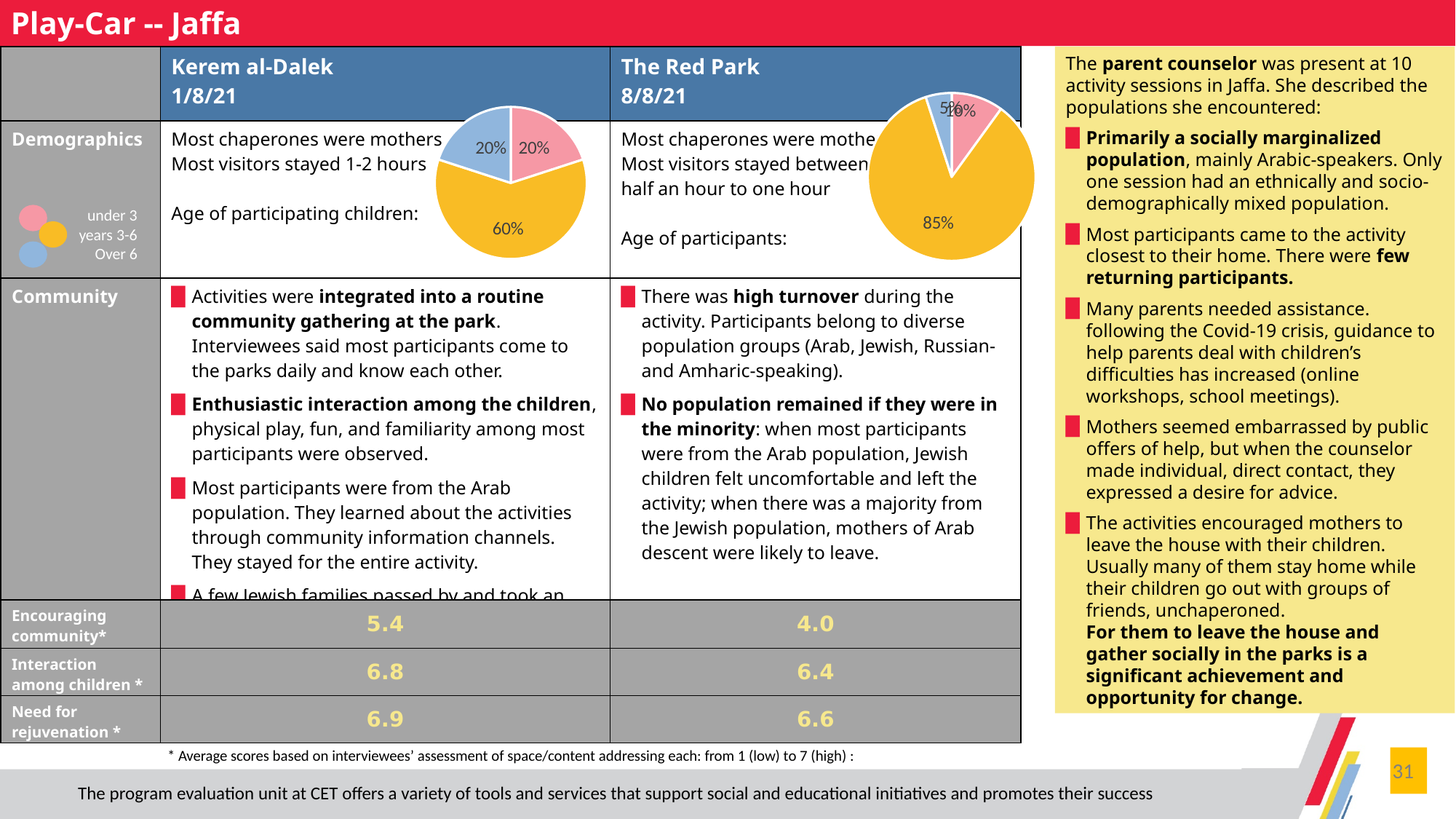
In the Kerem al-Dalek pie chart, what share of participating children were over 6? 20% In the Kerem al-Dalek pie chart, which age group has the largest share? years 3-6 Which park has a larger share of participants aged 3-6, Kerem al-Dalek or The Red Park? The Red Park How many age groups does the legend for the pie charts list? 3 What is the difference between the share of participants aged 3-6 at The Red Park and at Kerem al-Dalek? 25% In the Kerem al-Dalek pie chart, what share of participating children were under 3? 20% What is the difference between the share of children aged 3-6 and the share under 3 in the Kerem al-Dalek pie chart? 40% In The Red Park pie chart, which age group has the largest share? years 3-6 What type of chart is used to show the age of participants for each park? Pie chart Which colour represents the 'years 3-6' age group in the pie charts? Yellow In The Red Park pie chart, what share of participants were aged 3-6? 85% In the Kerem al-Dalek pie chart, what share of participating children were aged 3-6? 60%